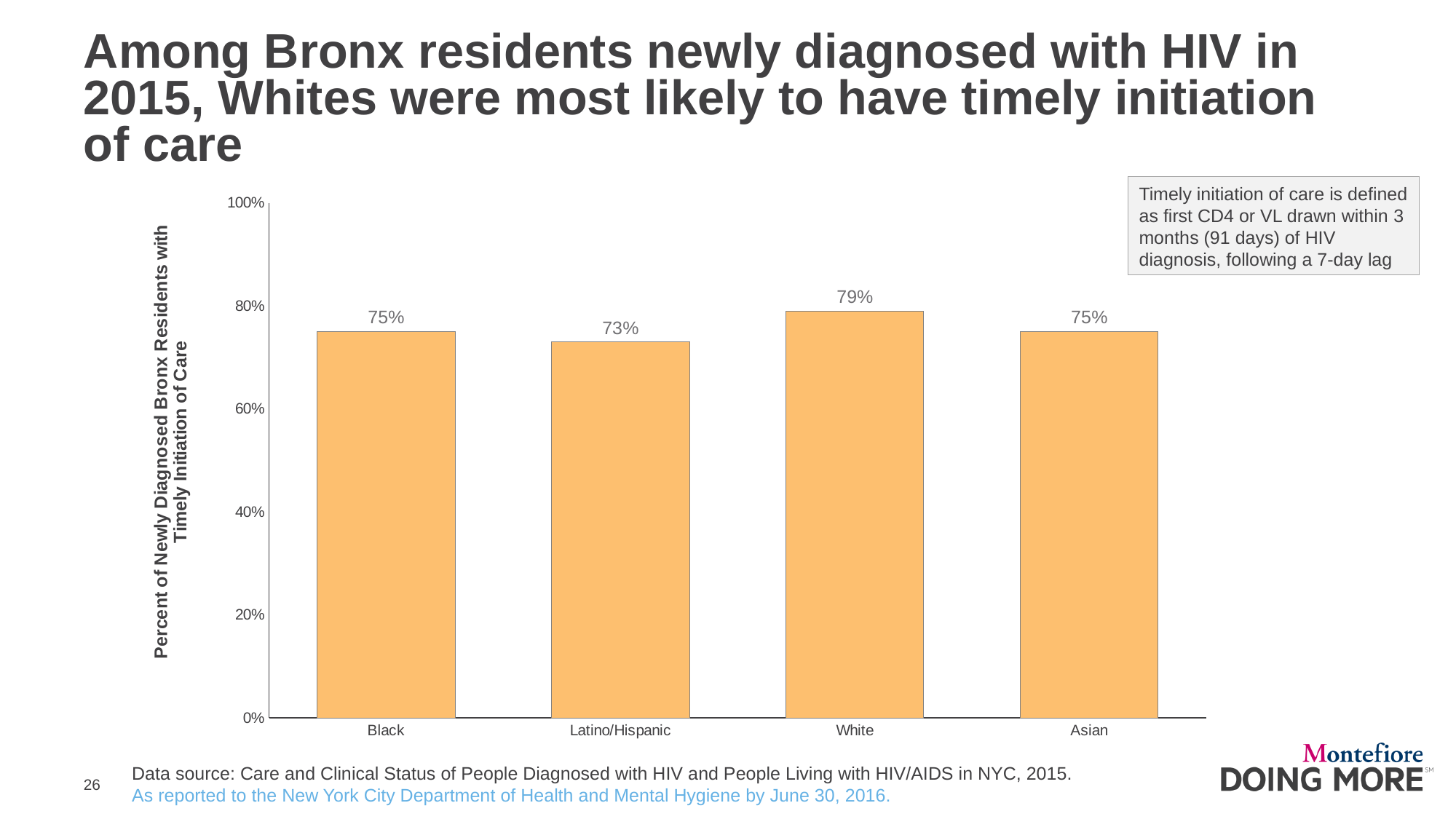
Which is larger, the value for White residents or the value for Black residents? White Which racial/ethnic group has the lowest percent with timely initiation of care? Latino/Hispanic What percent of newly diagnosed Black Bronx residents had timely initiation of care? 75% What is the label of the y axis? Percent of Newly Diagnosed Bronx Residents with Timely Initiation of Care What kind of chart is shown on the slide? Bar chart How many racial/ethnic groups are shown on the x axis? 4 Which racial/ethnic group has the highest percent with timely initiation of care? White What is the value shown for White residents? 79% What is the difference in percentage points between the White and Latino/Hispanic values? 6 percentage points What is the value shown for Latino/Hispanic residents? 73% Is the value for Latino/Hispanic residents greater or less than 80%? less What is the value shown for Asian residents? 75%